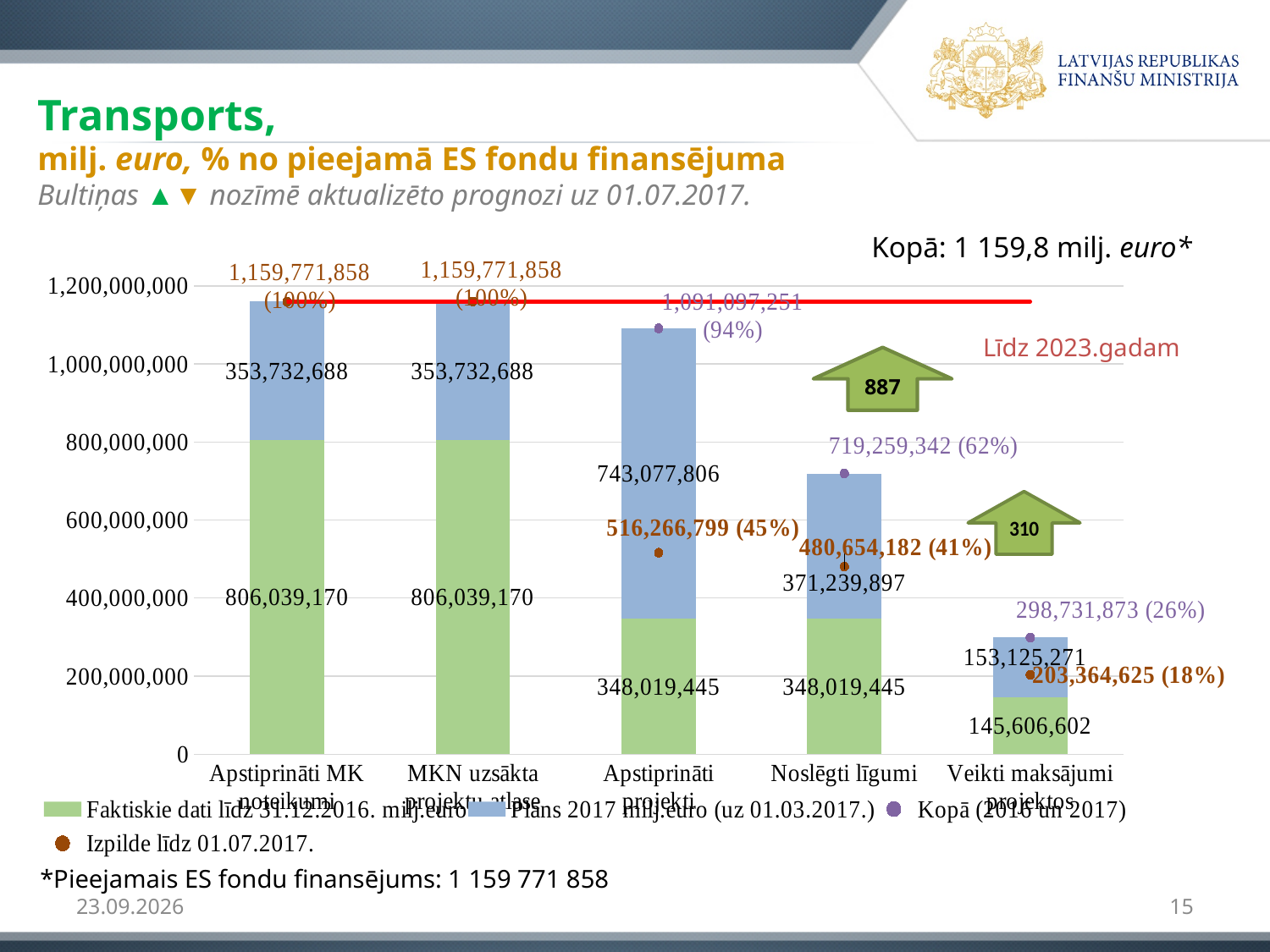
What is the difference between the 'Plāns 2017' values for 'Apstiprināti projekti' and 'Noslēgti līgumi'? 371,837,909 What is the 'Izpilde līdz 01.07.2017.' value for 'Apstiprināti projekti'? 516,266,799 (45%) Which category has the highest 'Plāns 2017' value? Apstiprināti projekti What is the total of the stacked bar for 'Veikti maksājumi projektos'? 298,731,873 What type of chart is shown on the slide? Stacked bar chart Which category has the lowest 'Faktiskie dati līdz 31.12.2016.' value? Veikti maksājumi projektos What is the value of 'Faktiskie dati līdz 31.12.2016.' for 'Apstiprināti projekti'? 348,019,445 How many categories are shown on the x axis of the chart? 5 Is the 'Izpilde līdz 01.07.2017.' value for 'Noslēgti līgumi' larger or smaller than that for 'Veikti maksājumi projektos'? Larger What is the value of 'Plāns 2017' for 'Noslēgti līgumi'? 371,239,897 How many series does the chart legend list? 4 What is the 'Kopā (2016 un 2017)' value for 'Veikti maksājumi projektos'? 298,731,873 (26%)